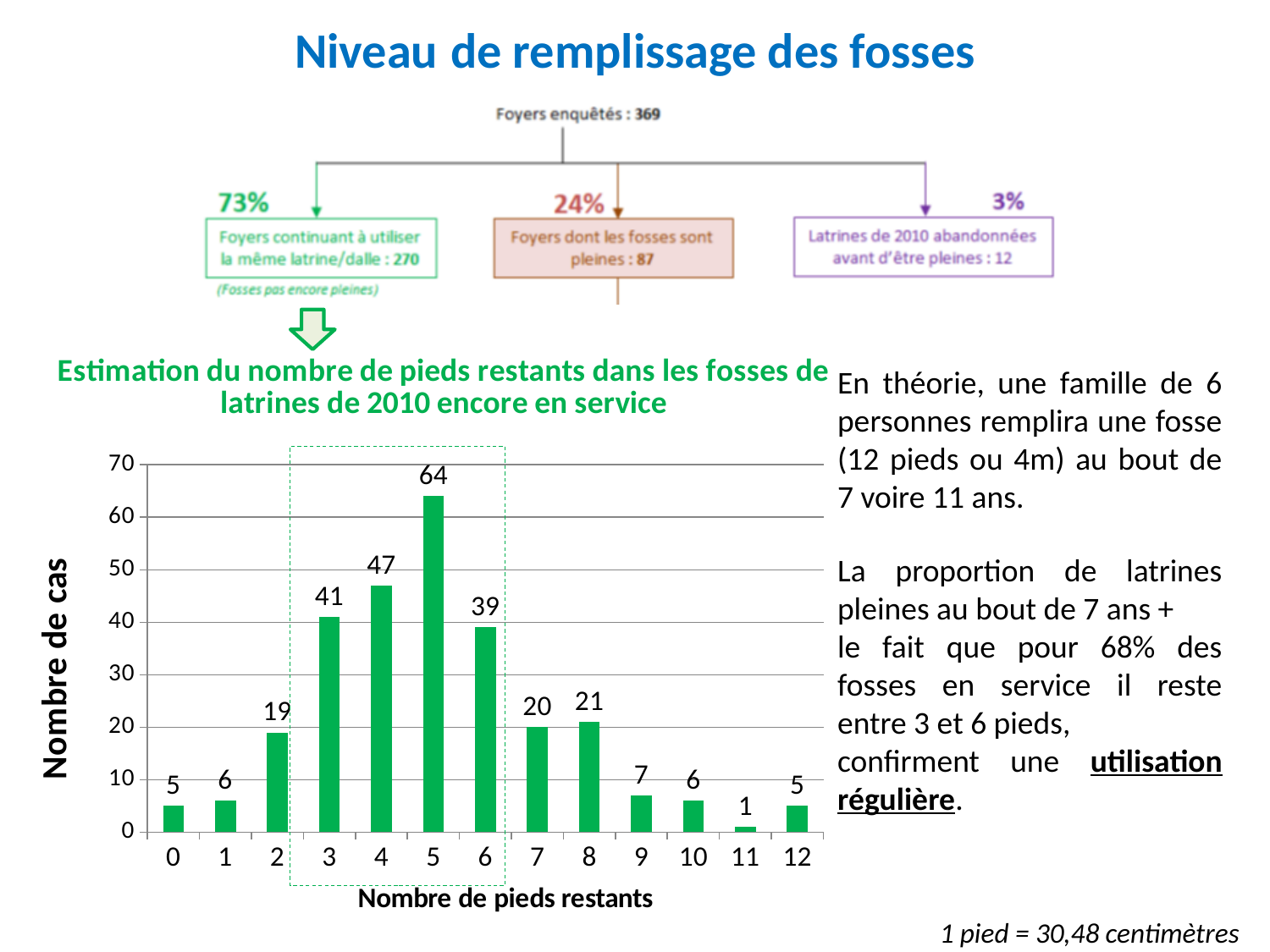
Which number of feet remaining has the lowest number of cases? 11 What is the difference in number of cases between 5 feet remaining and 4 feet remaining? 17 How many categories (numbers of feet remaining) are shown on the x axis? 13 Which has more cases: 3 feet remaining or 6 feet remaining? 3 feet remaining What is the number of cases for 11 feet remaining? 1 Is the number of cases for 8 feet remaining greater or less than 30? less What is the label of the y axis of the chart? Nombre de cas What is the number of cases for 2 feet remaining? 19 What is the number of cases for 5 feet remaining? 64 Which number of feet remaining has the highest number of cases? 5 What is the total number of cases for 3, 4, 5 and 6 feet remaining combined? 191 What kind of chart is shown on the slide? bar chart